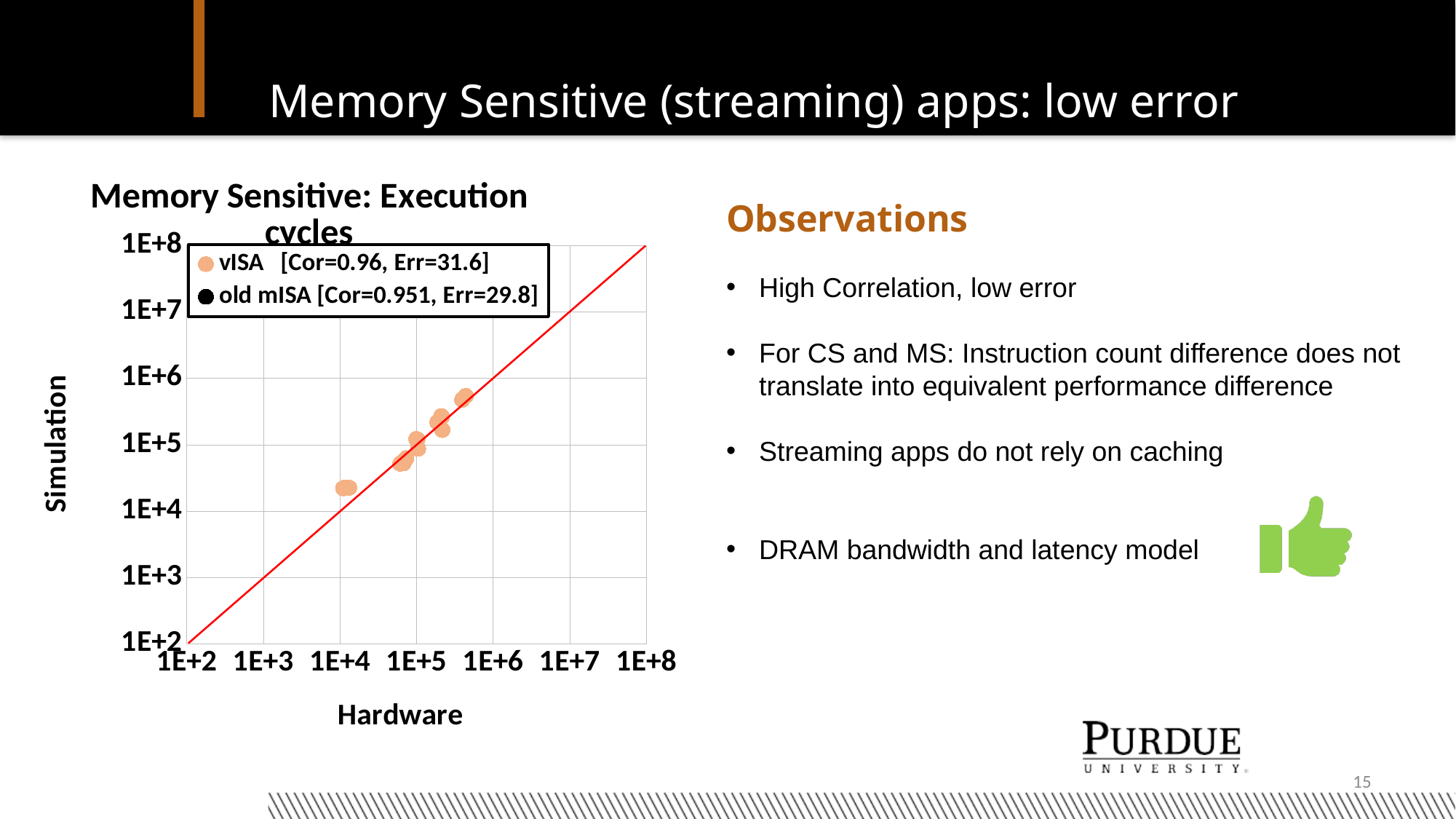
What error value does the legend give for the old mISA series? 29.8 What is the label of the x axis of the chart? Hardware What is the title of the chart on the slide? Memory Sensitive: Execution cycles Which series has the higher correlation according to the legend, vISA or old mISA? vISA Is the Simulation value of the highest plotted point greater or less than 1E+6? less What kind of chart is shown on the slide? Scatter chart What correlation value does the legend give for the vISA series? 0.96 What correlation value does the legend give for the old mISA series? 0.951 Is the Hardware value of the lowest plotted point greater or less than 1E+3? greater What is the label of the y axis of the chart? Simulation What error value does the legend give for the vISA series? 31.6 How many series does the chart's legend list? 2